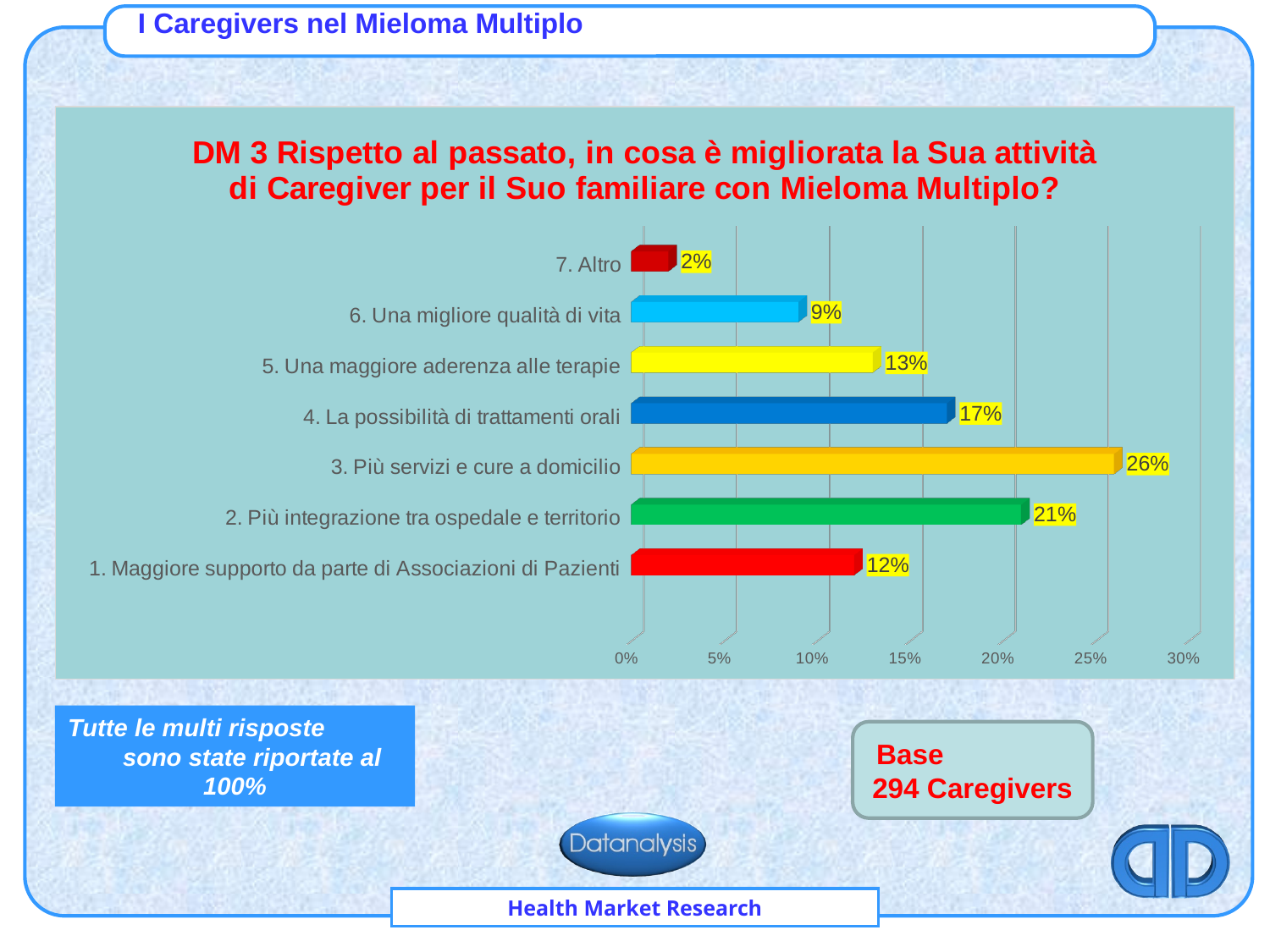
What is the value for "1. Maggiore supporto da parte di Associazioni di Pazienti"? 12% What is the difference between the values for "4. La possibilità di trattamenti orali" and "7. Altro"? 15% What is the difference between the values for "3. Più servizi e cure a domicilio" and "2. Più integrazione tra ospedale e territorio"? 5% What is the value for "6. Una migliore qualità di vita"? 9% What is the value for "3. Più servizi e cure a domicilio"? 26% Is the value for "2. Più integrazione tra ospedale e territorio" greater or less than 20%? greater Which is larger: the value for "4. La possibilità di trattamenti orali" or the value for "5. Una maggiore aderenza alle terapie"? 4. La possibilità di trattamenti orali Which category has the highest value? 3. Più servizi e cure a domicilio How many categories are shown in the chart? 7 What kind of chart is shown on the slide? bar chart Which category has the lowest value? 7. Altro What is the highest value shown on the x axis of the chart? 30%